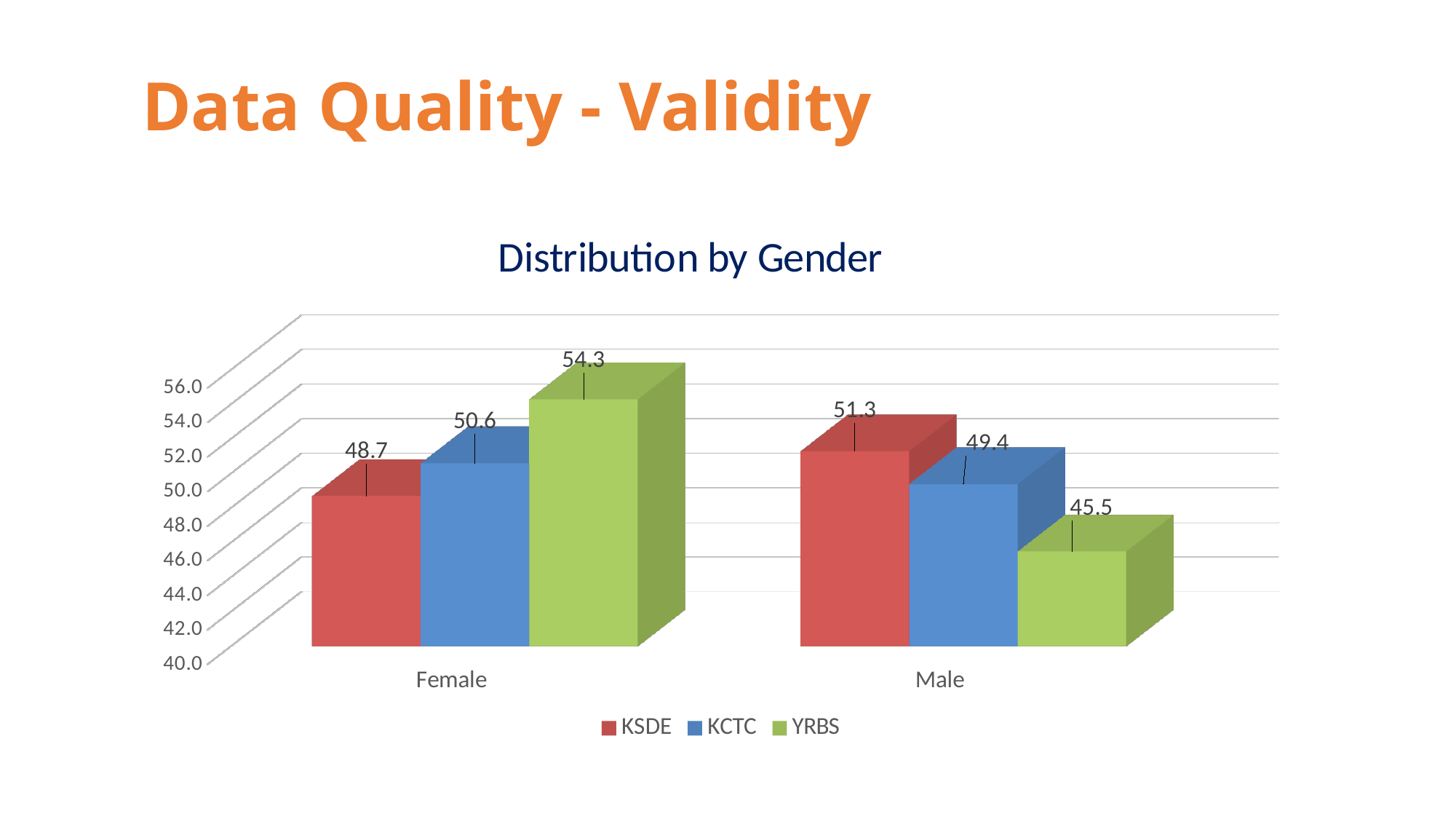
What is the title of the chart? Distribution by Gender Which series has the highest value for Female? YRBS How many categories are shown on the x axis? 2 What is the difference between the YRBS values for Female and Male? 8.8 What is the difference between the KCTC and KSDE values for Female? 1.9 Which series has the lowest value for Male? YRBS What kind of chart is shown? Bar chart What is the YRBS value for Male? 45.5 How many series does the legend list? 3 Which is larger, the KSDE value for Male or the KSDE value for Female? Male What is the KCTC value for Male? 49.4 What is the KSDE value for Female? 48.7